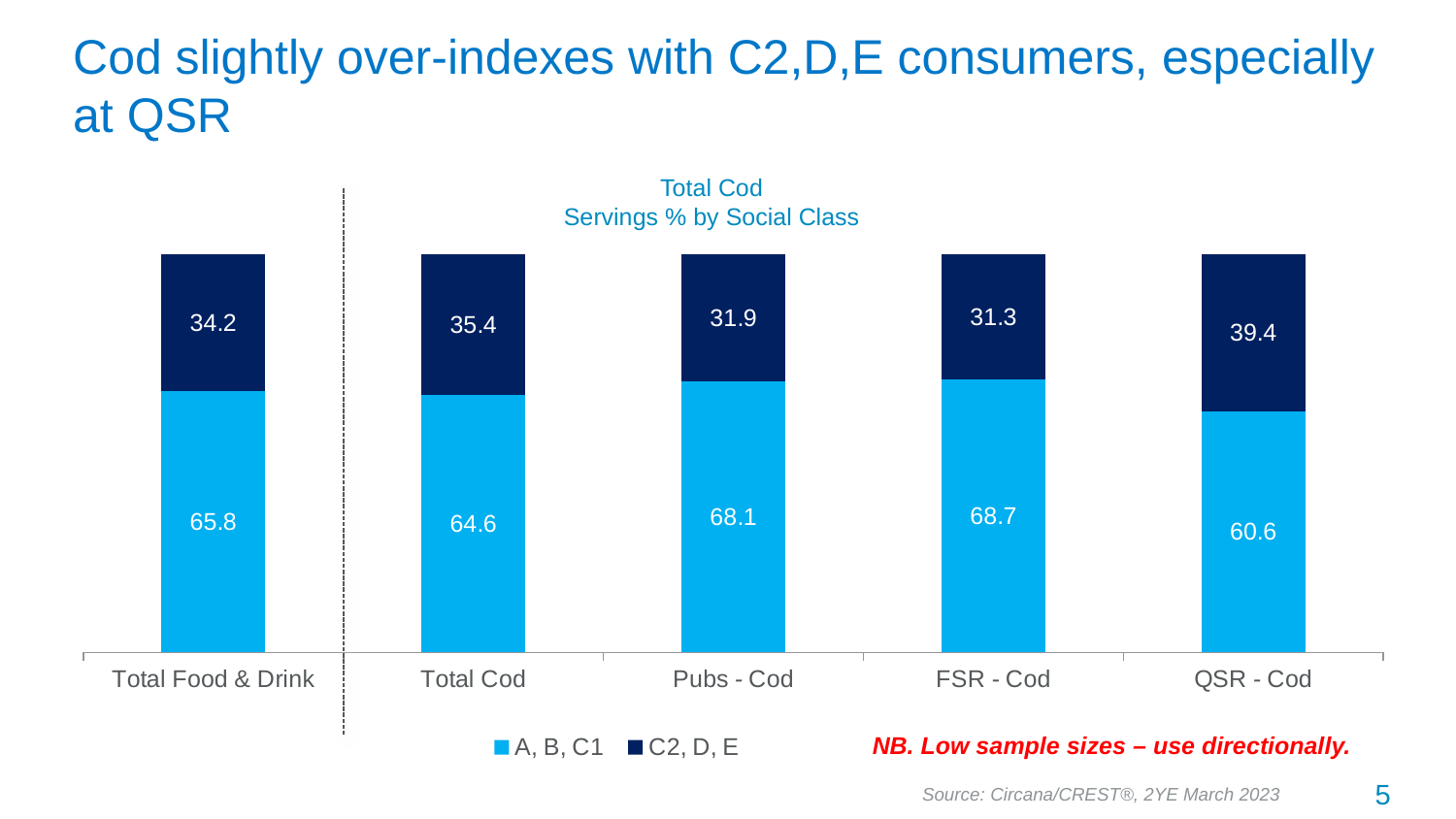
Which category has the highest C2, D, E value? QSR - Cod What is the difference between the A, B, C1 values for FSR - Cod and QSR - Cod? 8.1 What is the total of the stacked bar for Pubs - Cod? 100 What is the C2, D, E value for Total Food & Drink? 34.2 What is the A, B, C1 value for QSR - Cod? 60.6 What is the C2, D, E value for Pubs - Cod? 31.9 What is the title of the chart? Total Cod Servings % by Social Class How many series does the legend list? 2 What kind of chart is shown on the slide? Stacked bar chart Which is larger, the C2, D, E value for Total Cod or for FSR - Cod? Total Cod How many categories are shown on the x axis? 5 Which category has the lowest A, B, C1 value? QSR - Cod